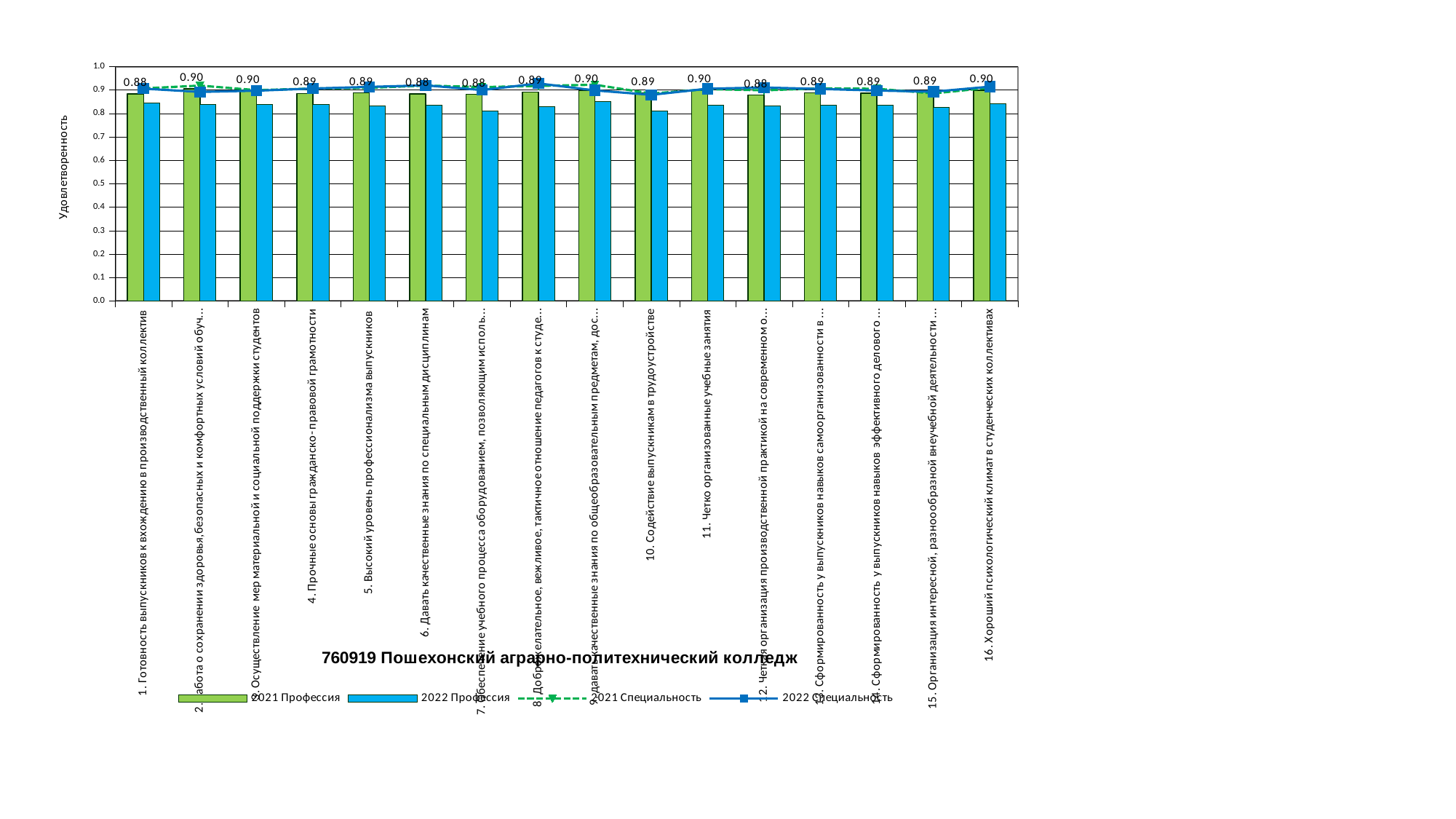
What kind of chart is shown on the slide? combination bar and line chart What is the 2021 Профессия value for "11. Четко организованные учебные занятия"? 0.90 What is the title of the chart? 760919 Пошехонский аграрно-политехнический колледж What is the label of the vertical axis? Удовлетворенность What is the difference between the 2021 Профессия values for category 16 (Хороший психологический климат) and category 1 (Готовность выпускников к вхождению в производственный коллектив)? 0.02 How many categories are plotted along the x axis? 16 How many series does the legend list? 4 What is the 2021 Профессия value for "16. Хороший психологический климат в студенческих коллективах"? 0.90 For "5. Высокий уровень профессионализма выпускников", which bar is taller: 2021 Профессия or 2022 Профессия? 2021 Профессия What is the 2021 Профессия value for "1. Готовность выпускников к вхождению в производственный коллектив"? 0.88 Is the 2022 Профессия value for "10. Содействие выпускникам в трудоустройстве" greater or less than 0.9? less What is the 2021 Профессия value for "6. Давать качественные знания по специальным дисциплинам"? 0.88